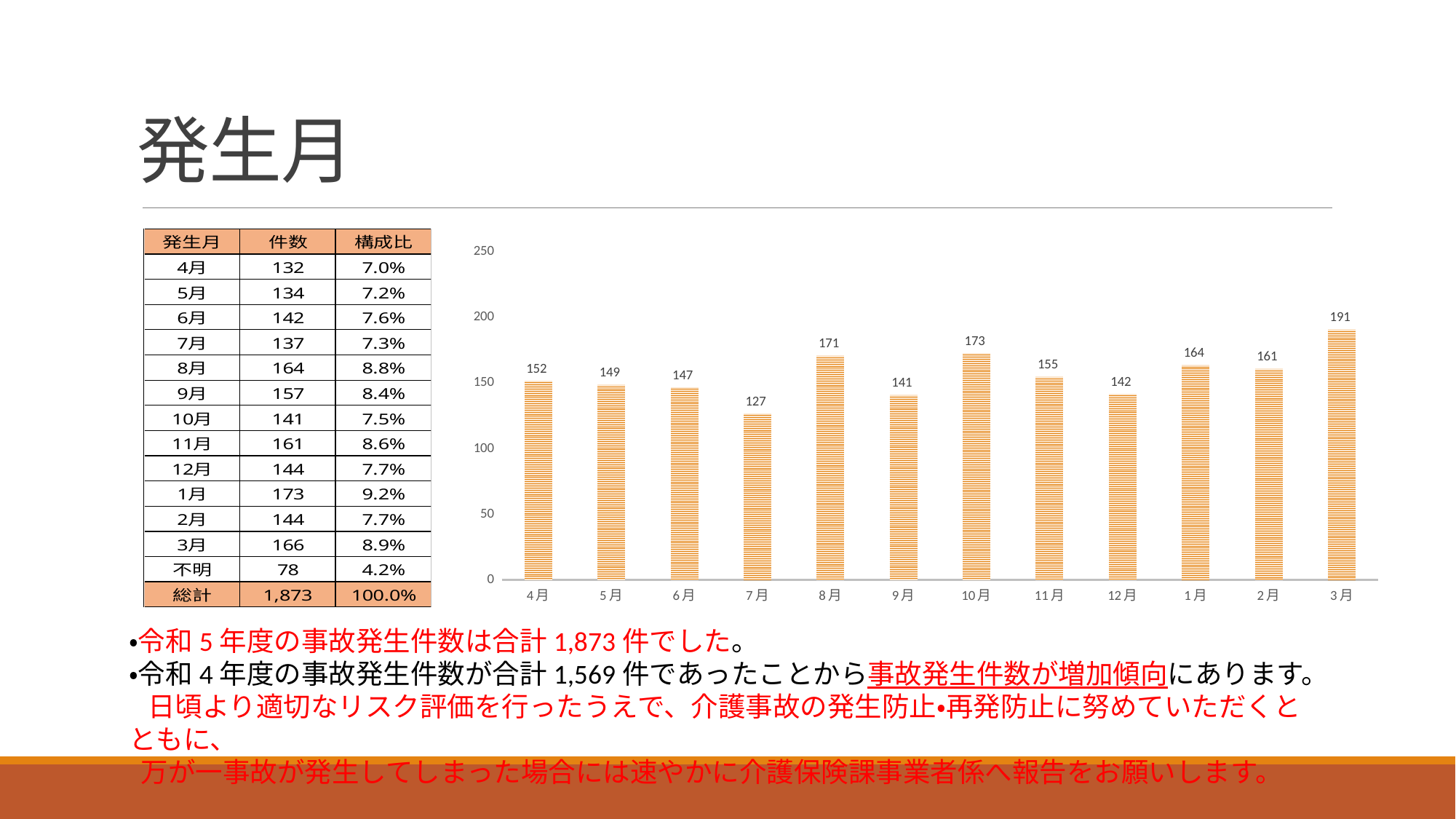
In the bar chart, what is the difference between the values for 1月 and 2月? 3 In the bar chart, which is larger, the value for 8月 or the value for 10月? 10月 What kind of chart is shown on the slide? bar chart What is the value shown for 7月 in the bar chart? 127 What is the value shown for 10月 in the bar chart? 173 What is the highest tick value shown on the vertical axis of the bar chart? 250 What is the value shown for 3月 in the bar chart? 191 Which month has the highest bar in the chart? 3月 How many months are plotted on the x axis of the bar chart? 12 In the bar chart, what is the difference between the values for 3月 and 7月? 64 Which month has the lowest bar in the chart? 7月 In the bar chart, is the value for 9月 greater or less than 150? less